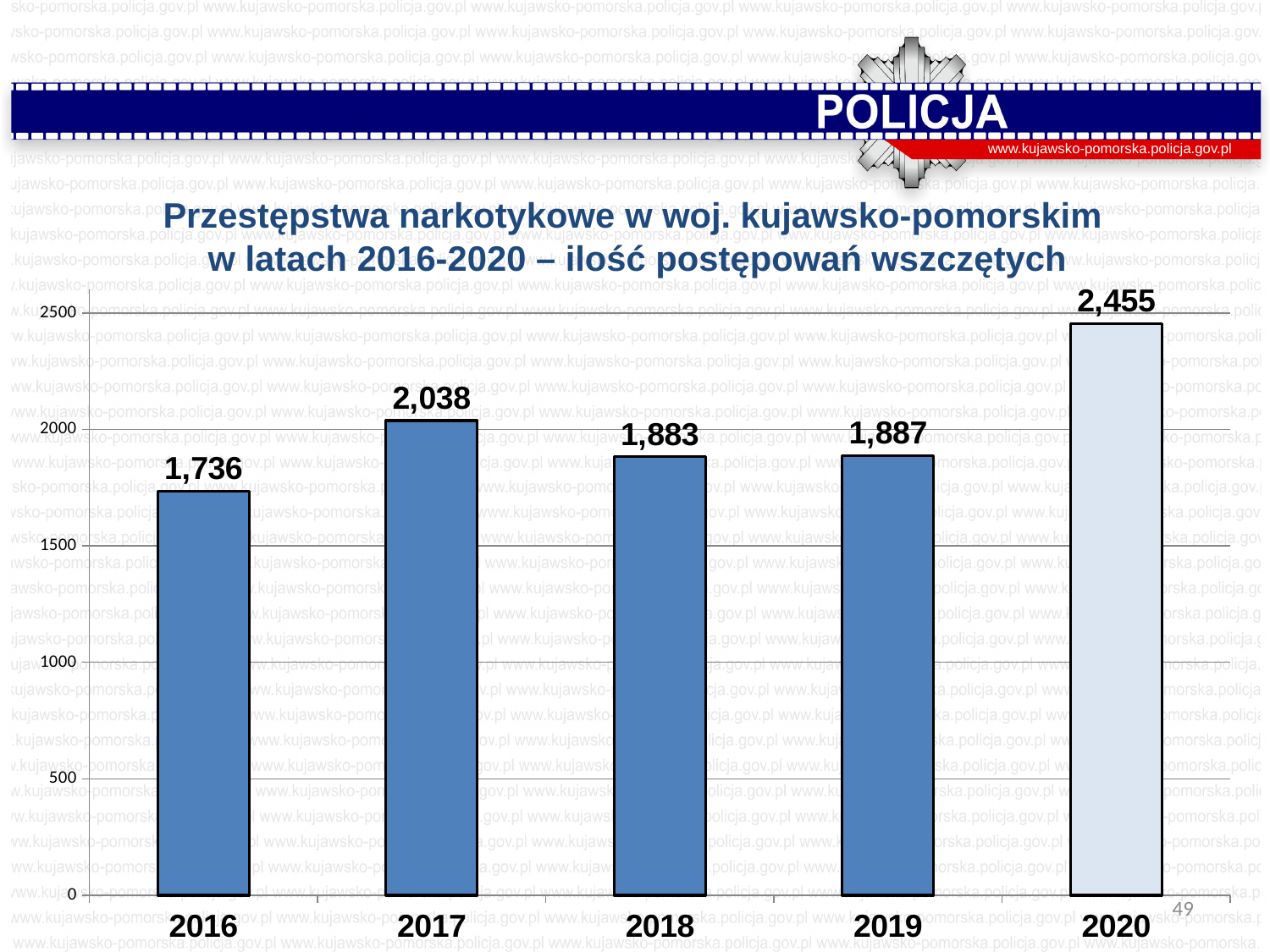
What is the value for 2017? 2,038 Which is larger, the value for 2017 or the value for 2019? 2017 Is the value for 2018 greater or less than 2000? less Which year has the lowest value? 2016 How many years are shown on the x axis? 5 What is the difference between the values for 2020 and 2016? 719 What kind of chart is shown on the slide? bar chart What is the value for 2016? 1,736 What is the value for 2019? 1,887 What is the difference between the values for 2017 and 2018? 155 Which year has the highest value? 2020 What is the value for 2020? 2,455